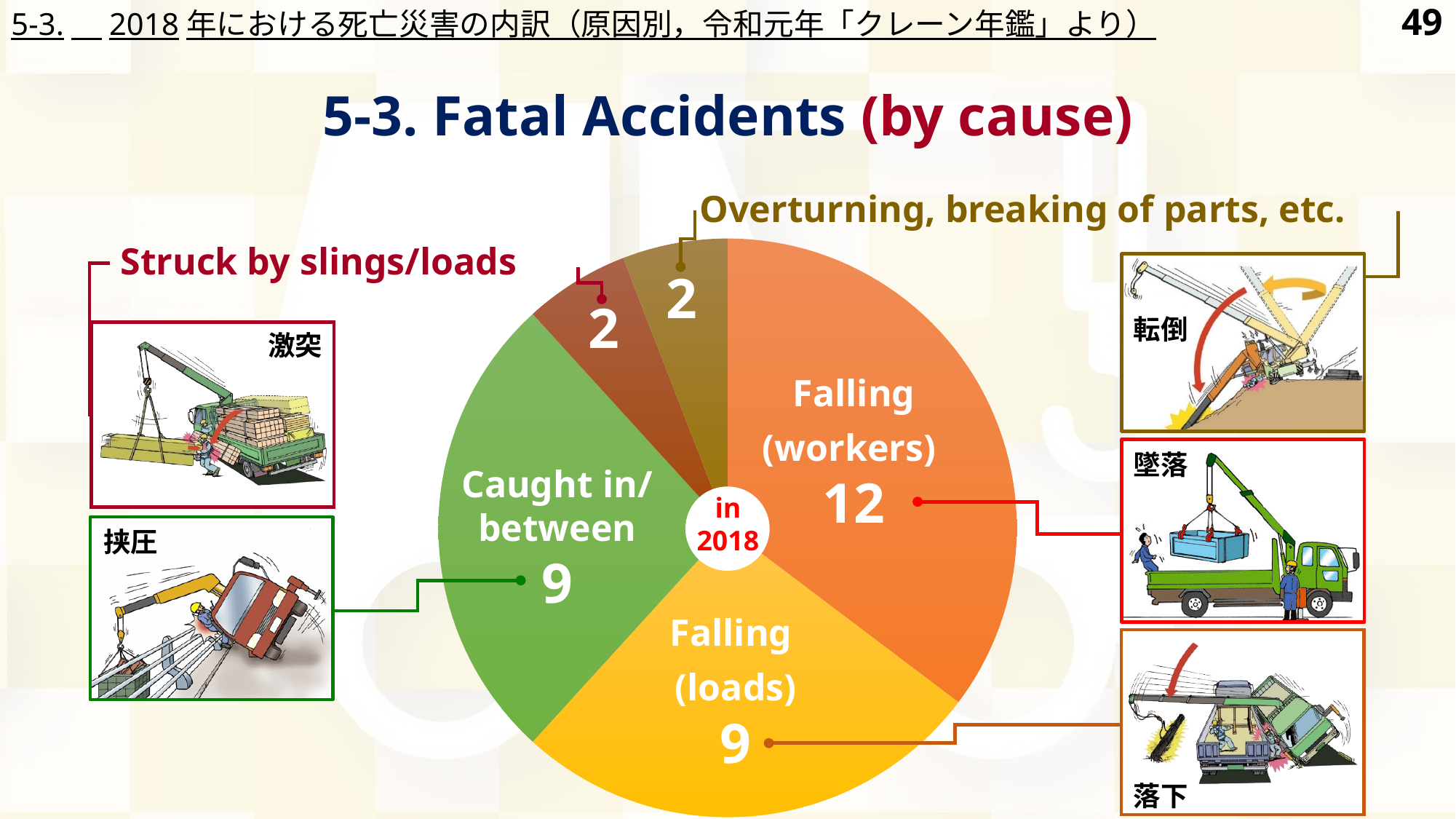
What type of chart is shown on the slide? pie chart How many cause categories are shown in the pie chart? 5 Which is larger: the number of fatal accidents from Caught in/between or from Struck by slings/loads? Caught in/between What is the difference between the number of fatal accidents from Falling (workers) and from Falling (loads)? 3 How many fatal accidents were caused by Struck by slings/loads? 2 What year do the fatal accident figures in the pie chart refer to? 2018 How many fatal accidents were caused by Caught in/between? 9 How many fatal accidents were caused by Falling (loads)? 9 How many fatal accidents were caused by Overturning, breaking of parts, etc.? 2 How many fatal accidents were caused by Falling (workers)? 12 Which cause accounts for the largest number of fatal accidents? Falling (workers) What is the total number of fatal accidents shown in the pie chart? 34